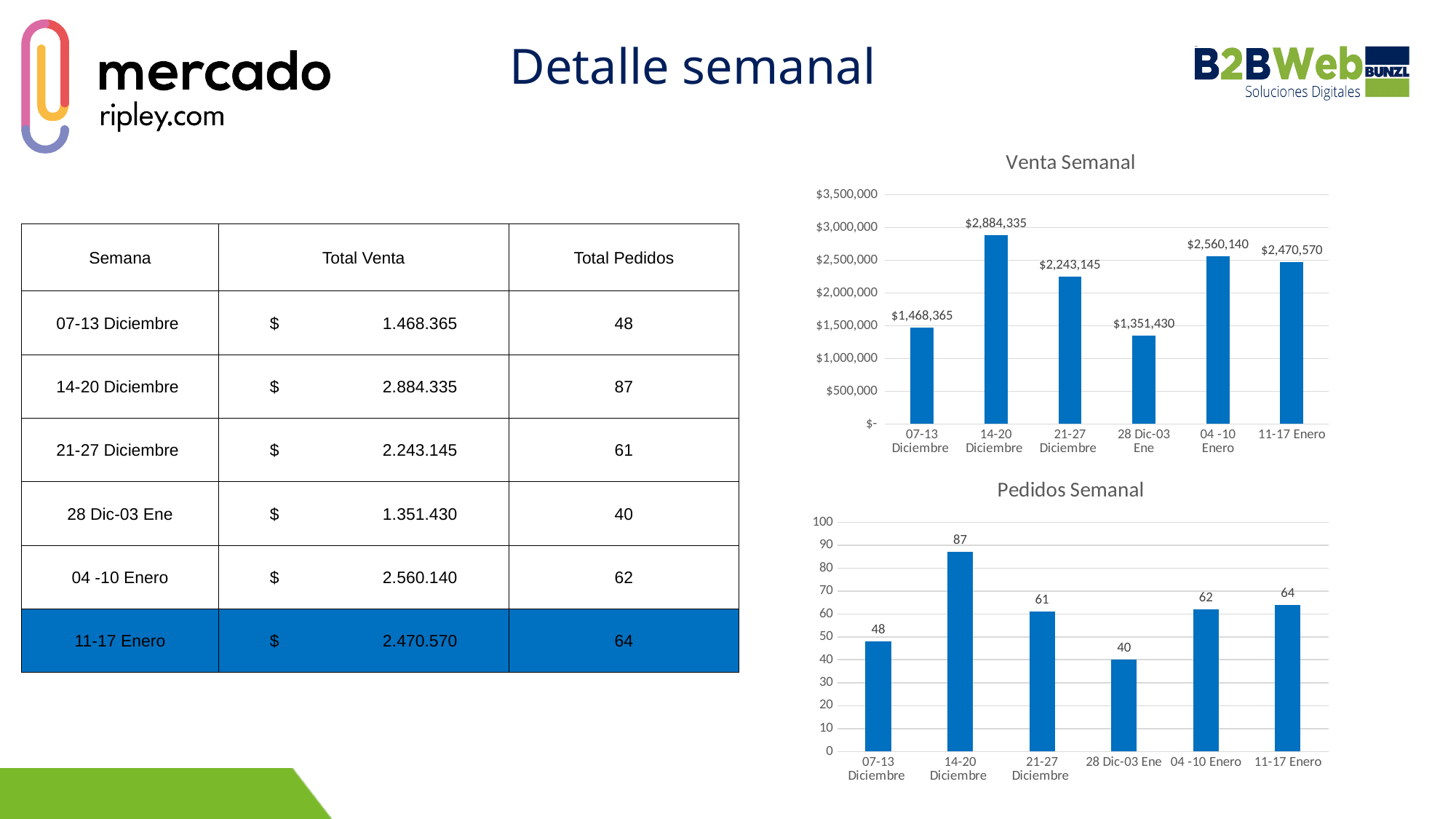
In the Pedidos Semanal chart, do the values rise or fall from 28 Dic-03 Ene to 11-17 Enero? rise In the Venta Semanal chart, how many weeks are plotted? 6 In the Pedidos Semanal chart, which week has the highest value? 14-20 Diciembre In the Pedidos Semanal chart, what is the difference between 14-20 Diciembre and 11-17 Enero? 23 In the Venta Semanal chart, is the value for 07-13 Diciembre greater or less than $1,500,000? less In the Venta Semanal chart, what is the value for 14-20 Diciembre? $2,884,335 What kind of chart is the Pedidos Semanal chart? bar chart In the Venta Semanal chart, what is the difference between 04 -10 Enero and 11-17 Enero? $89,570 In the Venta Semanal chart, which week has the lowest value? 28 Dic-03 Ene In the Pedidos Semanal chart, what is the value for 21-27 Diciembre? 61 What is the title of the top chart on the slide? Venta Semanal In the Pedidos Semanal chart, which is larger: 07-13 Diciembre or 28 Dic-03 Ene? 07-13 Diciembre